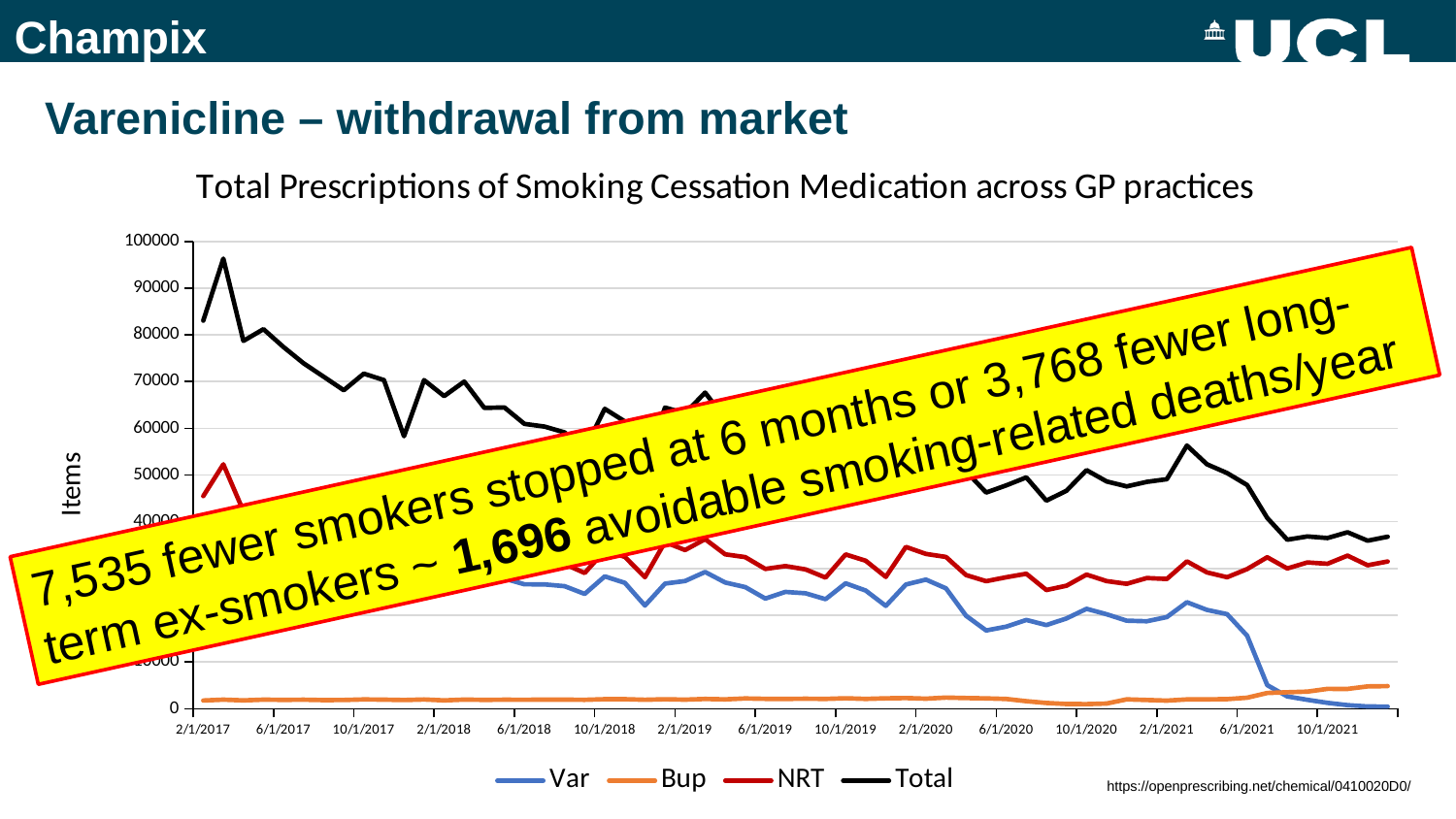
Does the Var series rise or fall between 6/1/2021 and 10/1/2021? fall What is the label on the vertical axis? Items Which series has the highest values across the chart? Total How many series does the legend list? 4 Is the value of the Total series at 10/1/2021 greater or less than 40000? less What are the series names listed in the legend? Var, Bup, NRT, Total Which series has the lowest values across the chart? Bup At 10/1/2021, which is larger, the Var value or the NRT value? NRT Is the highest value of the Total series greater or less than 90000? greater Is the value of the Var series at 10/1/2021 greater or less than 10000? less What kind of chart is shown on the slide? line chart